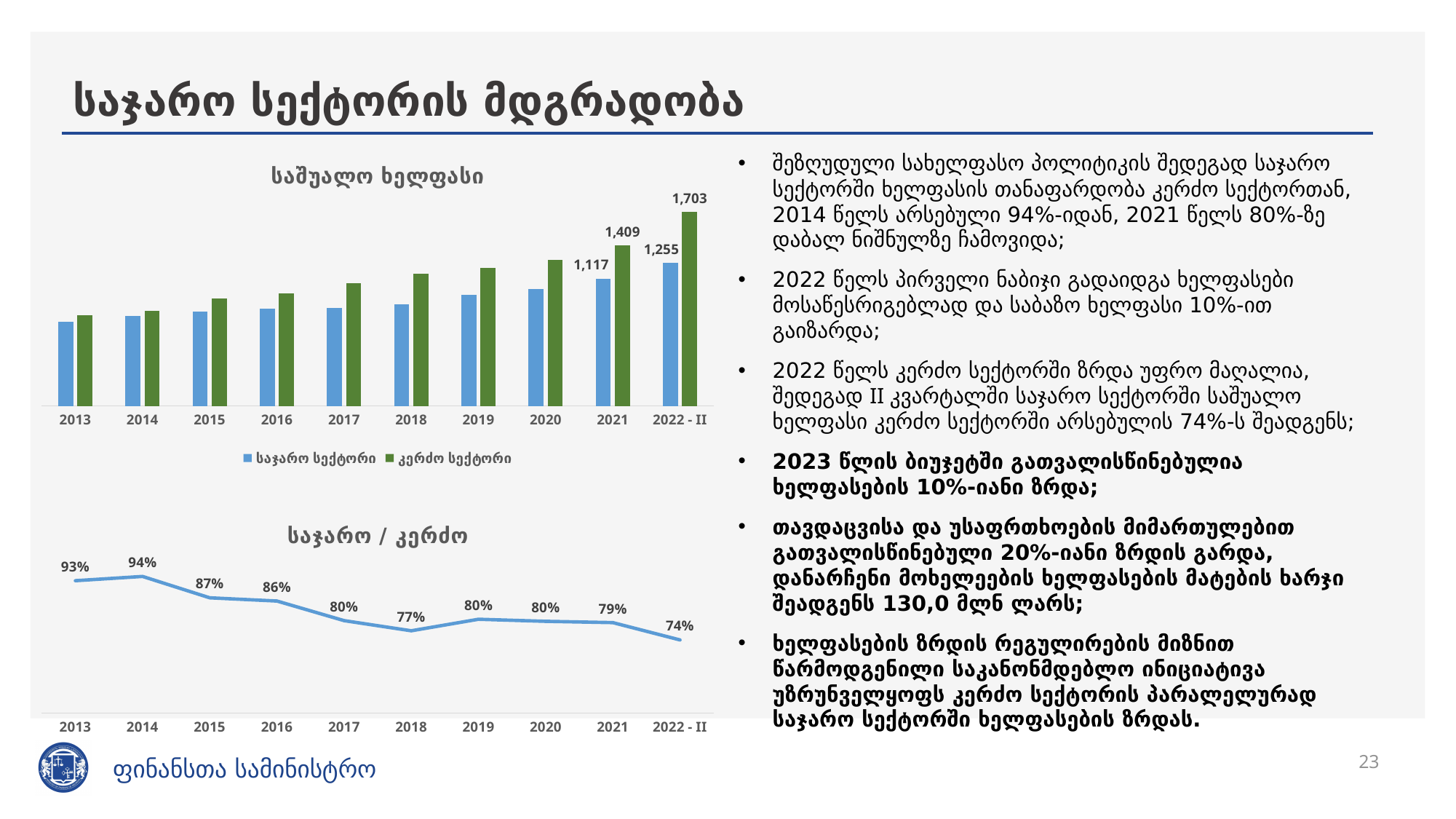
In the bar chart titled "საშუალო ხელფასი", what is the difference between კერძო სექტორი and საჯარო სექტორი in 2022 - II? 448 In the bar chart titled "საშუალო ხელფასი", what is the value for საჯარო სექტორი in 2021? 1,117 What kind of chart is the lower chart titled "საჯარო / კერძო"? line chart In the line chart titled "საჯარო / კერძო", which year has the highest value? 2014 In the line chart titled "საჯარო / კერძო", what is the value for 2018? 77% In the bar chart titled "საშუალო ხელფასი", how many year categories are shown on the x axis? 10 In the line chart titled "საჯარო / კერძო", what is the difference between the 2014 value and the 2022 - II value? 20% In the line chart titled "საჯარო / კერძო", which category has the lowest value? 2022 - II In the bar chart titled "საშუალო ხელფასი", what is the value for კერძო სექტორი in 2022 - II? 1,703 In the bar chart titled "საშუალო ხელფასი", do the კერძო სექტორი values rise or fall from 2013 to 2022 - II? rise In the bar chart titled "საშუალო ხელფასი", which is larger in 2021: საჯარო სექტორი or კერძო სექტორი? კერძო სექტორი In the bar chart titled "საშუალო ხელფასი", how many series does the legend list? 2